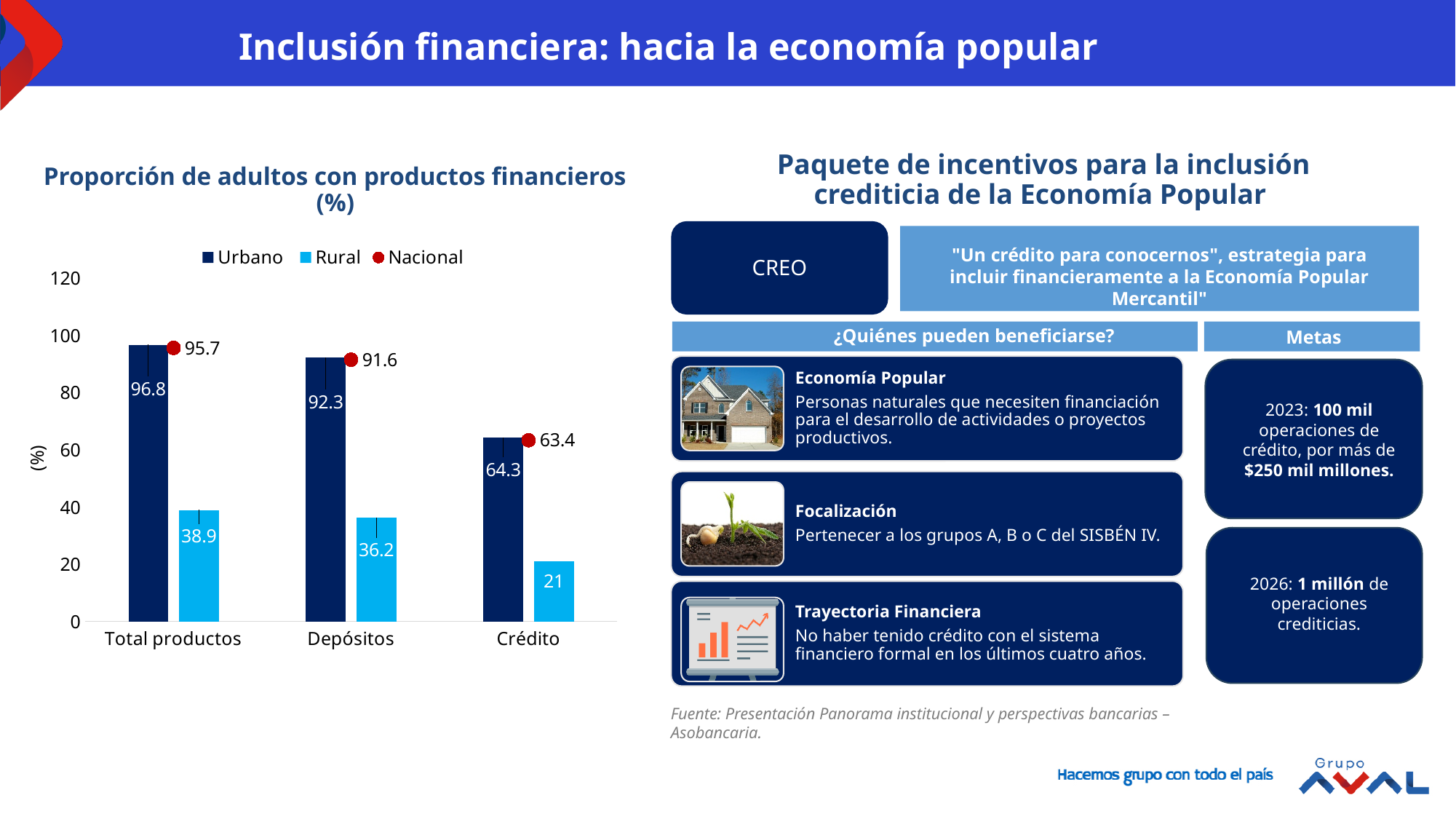
How many categories are shown on the x axis? 3 What is the difference between the Urbano and Rural values for Total productos? 57.9 What is the title of the chart? Proporción de adultos con productos financieros (%) What kind of chart is shown on the slide? Bar chart Which category has the highest Urbano value? Total productos What is the Rural value for Crédito? 21 What is the Urbano value for Total productos? 96.8 Which category has the lowest Rural value? Crédito What is the Rural value for Depósitos? 36.2 What is the Nacional value for Crédito? 63.4 How many series does the legend list? 3 Which is larger, the Urbano value for Depósitos or the Urbano value for Crédito? Depósitos